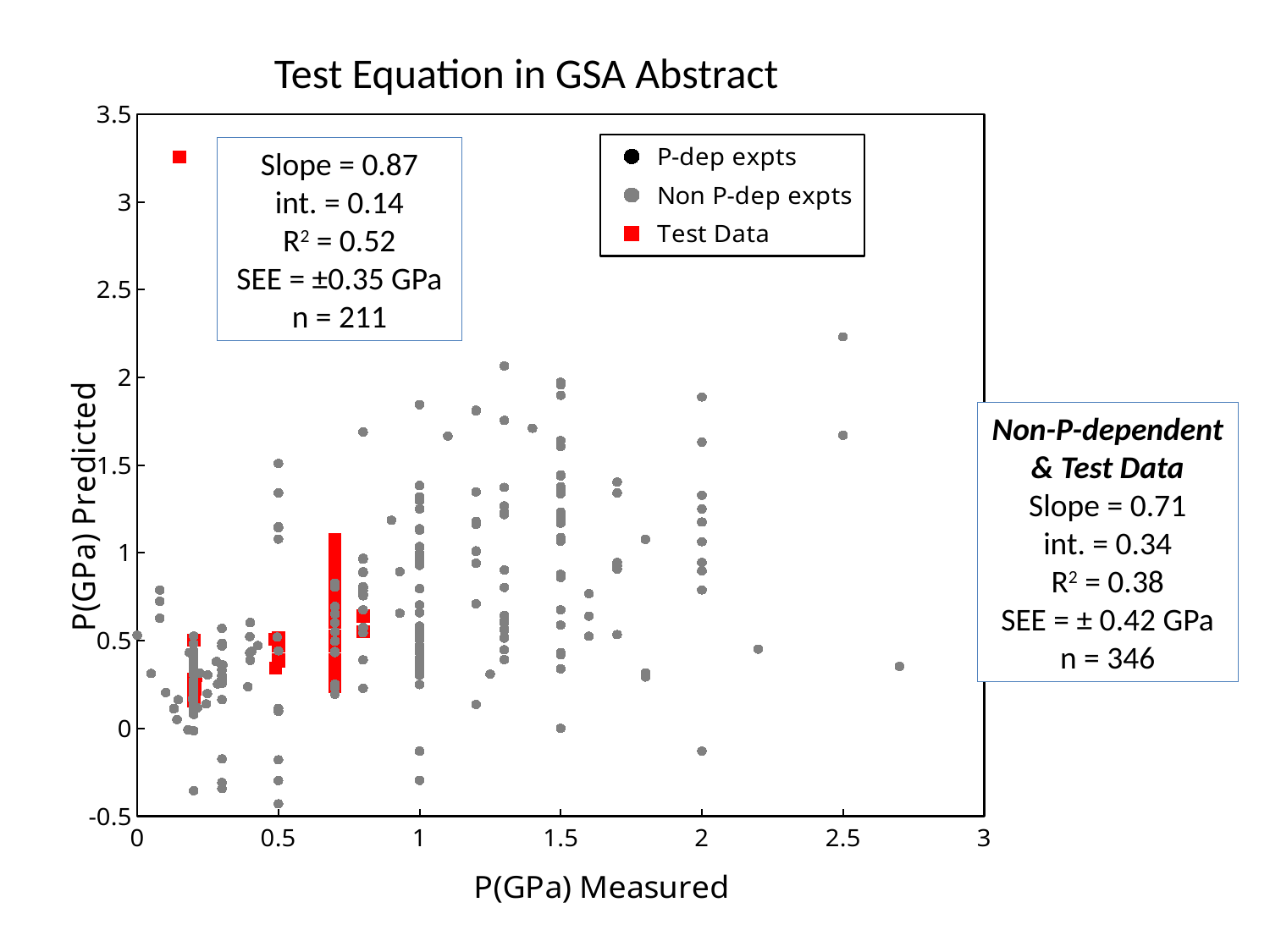
What SEE is reported for the Non-P-dependent & Test Data fit? ± 0.42 GPa Which legend entry is shown with red square markers? Test Data What is the title of the chart? Test Equation in GSA Abstract What kind of chart is shown on the slide? scatter chart What slope is reported in the upper-left statistics box? 0.87 What is the label of the x axis? P(GPa) Measured What is the value of n in the upper-left statistics box? 211 What is the label of the y axis? P(GPa) Predicted How many series does the legend list? 3 What R² value is reported for the Non-P-dependent & Test Data fit? 0.38 Is the predicted value for the point at a measured pressure of 2.7 GPa greater or less than 0.5? less Is the highest predicted value at a measured pressure of 2.5 GPa greater or less than 2? greater